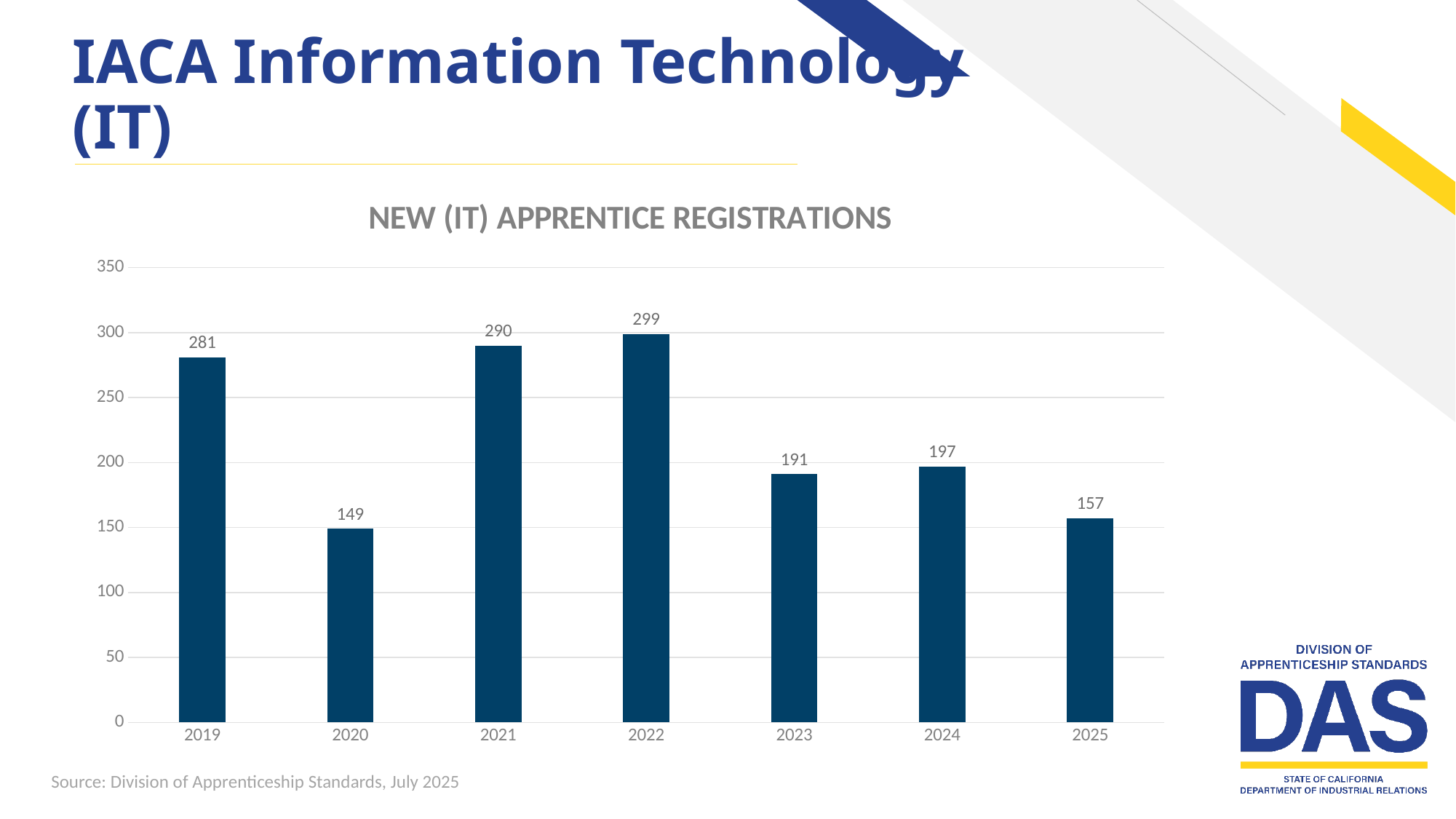
Which year has the lowest number of new IT apprentice registrations? 2020 What is the number of new IT apprentice registrations in 2025? 157 What is the title of the chart? NEW (IT) APPRENTICE REGISTRATIONS Which year has the highest number of new IT apprentice registrations? 2022 What kind of chart is shown on the slide? Bar chart Which year had more new IT apprentice registrations, 2021 or 2024? 2021 What is the difference between the registrations in 2024 and 2025? 40 What is the difference between the registrations in 2022 and 2020? 150 Is the value for 2020 greater or less than 150? less What is the number of new IT apprentice registrations in 2019? 281 What is the number of new IT apprentice registrations in 2023? 191 How many years are shown on the chart? 7